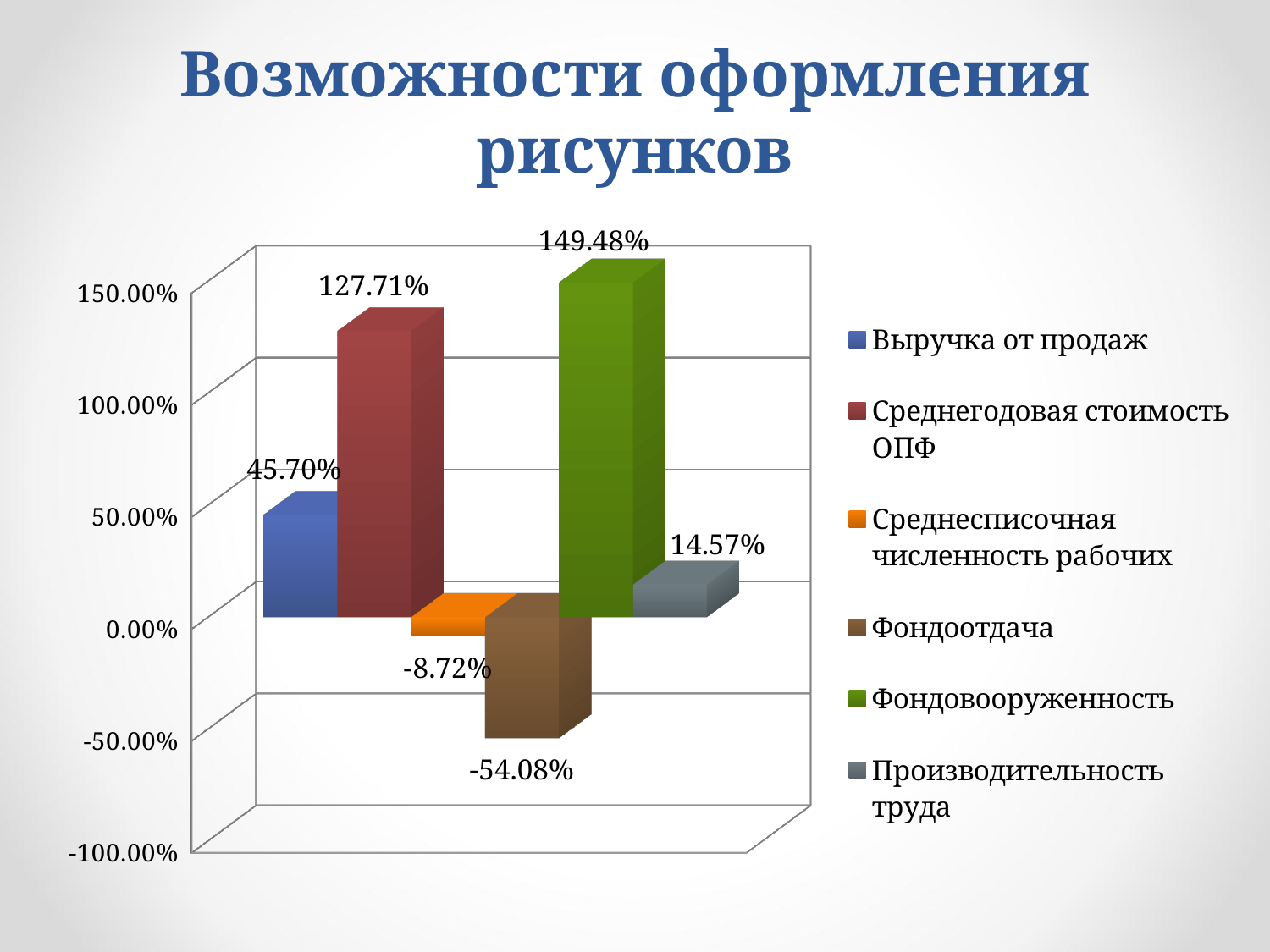
What is the difference between the values for Фондовооруженность and Среднегодовая стоимость ОПФ? 21.77% How many series does the legend list? 6 Is the value for Среднегодовая стоимость ОПФ greater or less than 100.00%? greater What is the value for Выручка от продаж? 45.70% Which series has the highest value? Фондовооруженность What is the value for Фондоотдача? -54.08% What kind of chart is shown on the slide? bar chart Which series has the lowest value? Фондоотдача What is the value for Среднегодовая стоимость ОПФ? 127.71% What is the value for Среднесписочная численность рабочих? -8.72% What is the value for Производительность труда? 14.57% Which is larger, the value for Выручка от продаж or the value for Производительность труда? Выручка от продаж